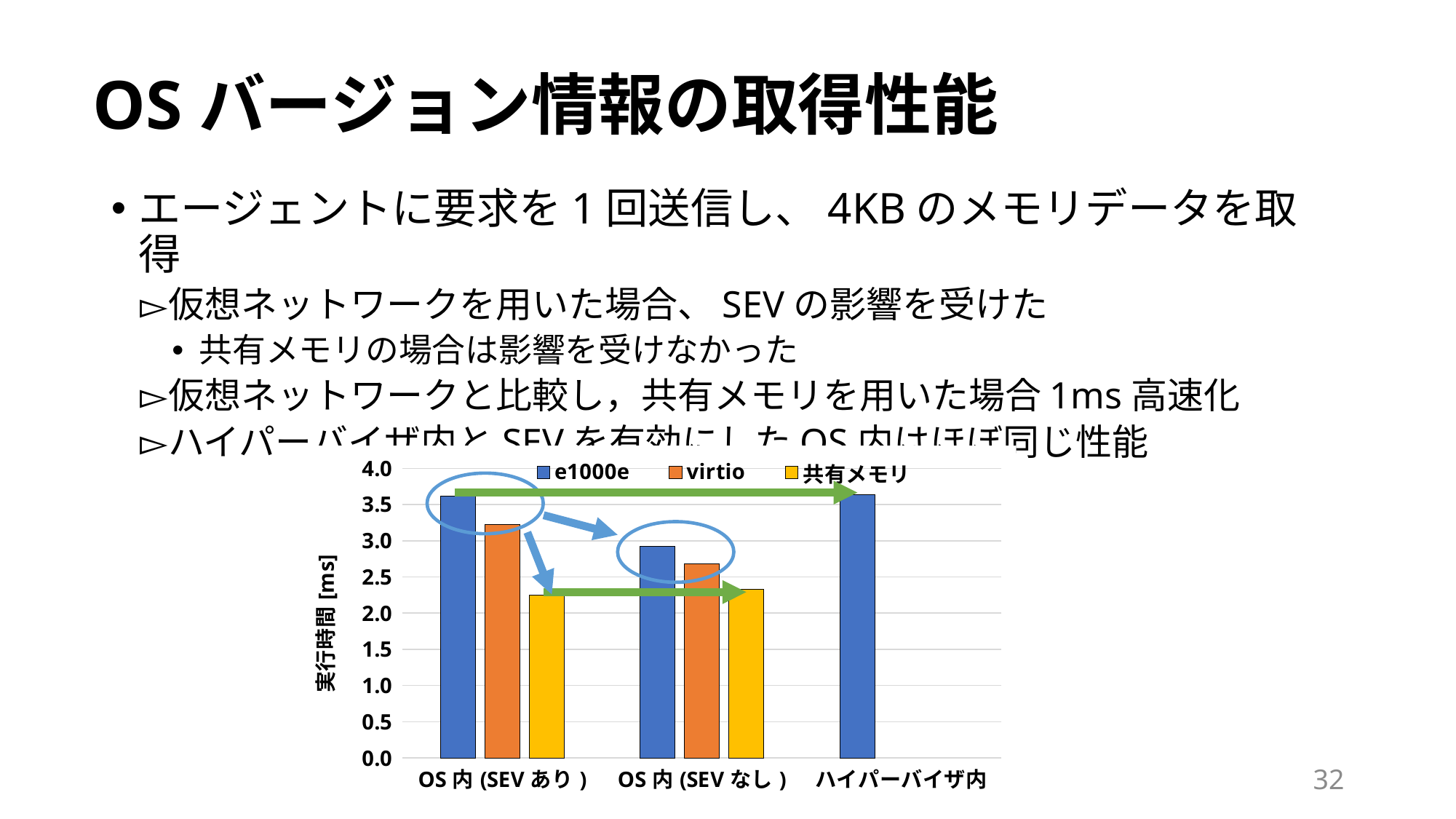
What kind of chart is shown on the slide? bar chart For the e1000e series, which is larger: the value for OS内(SEVあり) or the value for OS内(SEVなし)? OS内(SEVあり) Which series has the highest value in the OS内(SEVあり) category? e1000e Is the virtio value for OS内(SEVなし) greater or less than 2.5? greater How many series does the chart legend list? 3 Is the e1000e value for OS内(SEVあり) greater or less than 3.5? greater Is the virtio value for OS内(SEVあり) greater or less than 3.0? greater How many categories are shown on the x axis of the chart? 3 Which series has the lowest value in the OS内(SEVなし) category? 共有メモリ What is the label of the vertical axis of the chart? 実行時間 [ms]